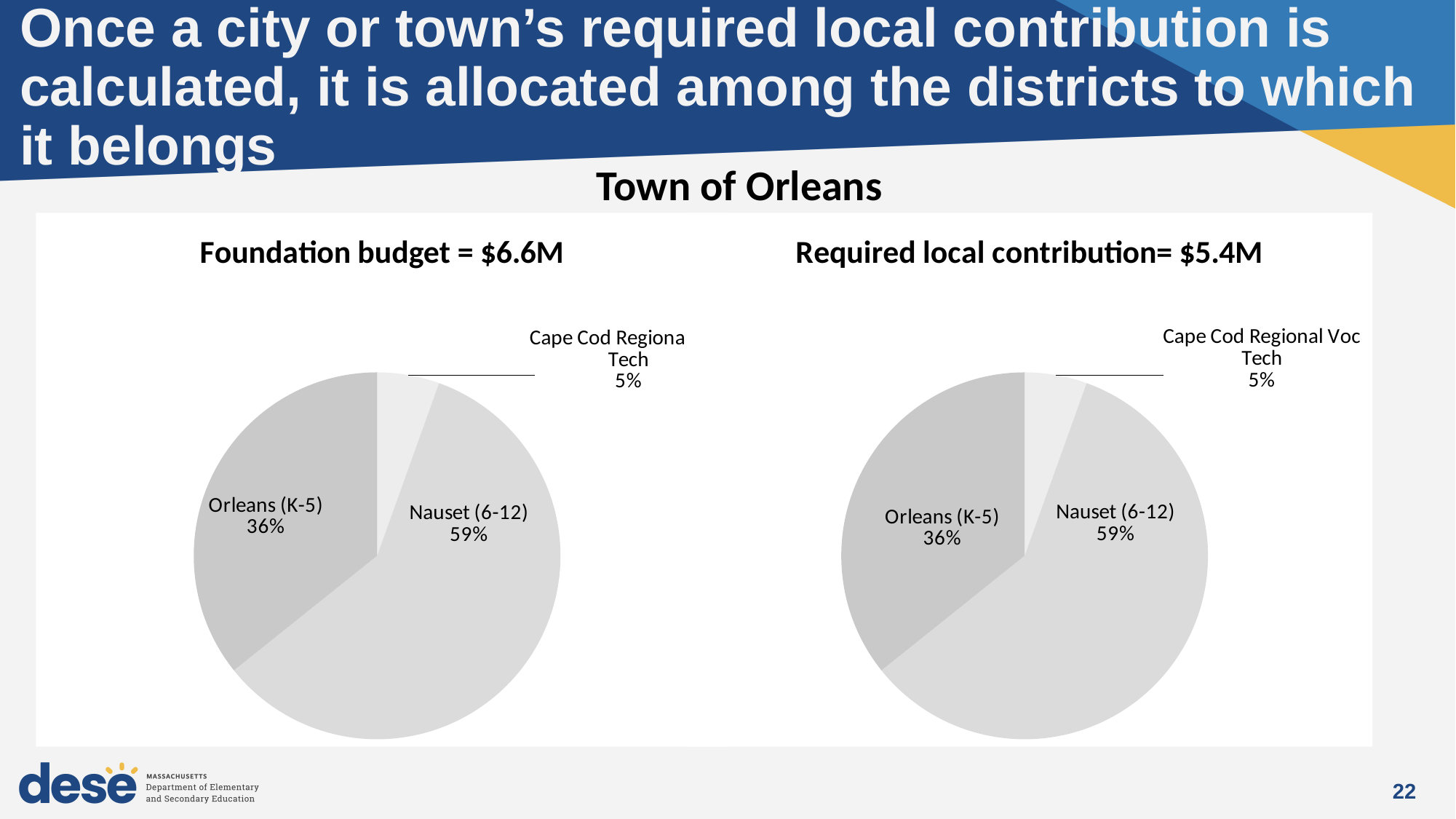
In the Foundation budget = $6.6M chart, what share does Nauset (6-12) have? 59% In the Foundation budget = $6.6M chart, what is the difference in percentage points between Nauset (6-12) and Orleans (K-5)? 23 What type of chart is used for the Required local contribution= $5.4M chart? Pie chart In the Required local contribution= $5.4M chart, which is larger, Orleans (K-5) or Cape Cod Regional Voc Tech? Orleans (K-5) In the Required local contribution= $5.4M chart, which district has the largest slice? Nauset (6-12) In the Foundation budget = $6.6M chart, which district has the smallest slice? Cape Cod Regional Tech In the Required local contribution= $5.4M chart, what is the combined share of Orleans (K-5) and Nauset (6-12)? 95% In the Foundation budget = $6.6M chart, what share does Cape Cod Regional Tech have? 5% What is the title of the left pie chart? Foundation budget = $6.6M In the Required local contribution= $5.4M chart, what share does Orleans (K-5) have? 36% What town do the two pie charts on the slide describe? Town of Orleans How many slices does the Foundation budget = $6.6M pie chart have? 3